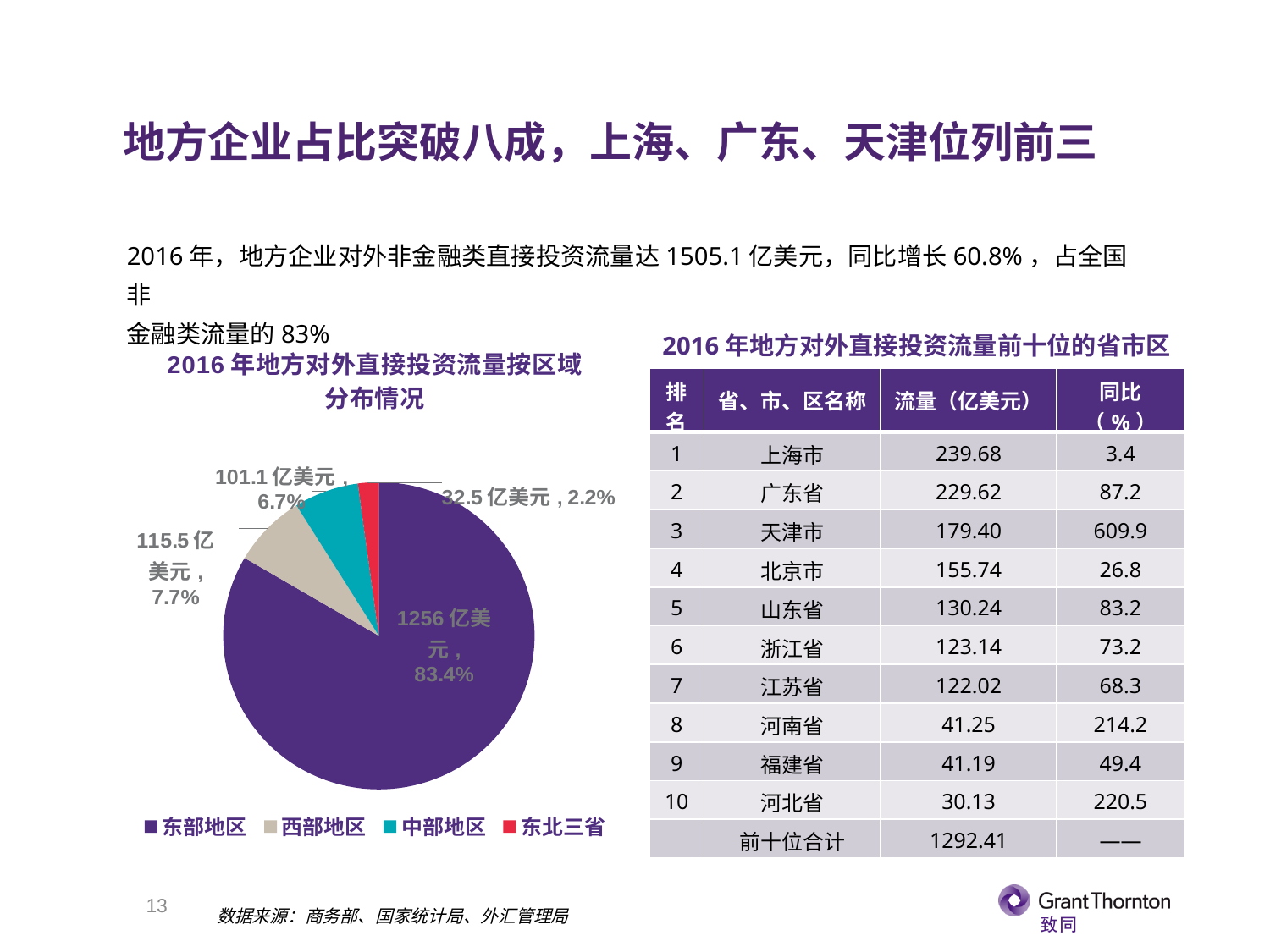
Which region has the smallest slice in the pie chart? 东北三省 In the pie chart, what is the value for 东北三省? 32.5 亿美元 In the pie chart, which is larger, 西部地区 or 中部地区? 西部地区 In the pie chart, what is the difference in value between 西部地区 and 中部地区? 14.4 亿美元 In the pie chart, what share does 东部地区 hold? 83.4% In the pie chart, what is the value for 西部地区? 115.5 亿美元 In the pie chart, what share does 中部地区 hold? 6.7% What is the title of the pie chart? 2016 年地方对外直接投资流量按区域分布情况 What kind of chart is shown on the left of the slide? Pie chart In the pie chart, what is the value for 东部地区? 1256 亿美元 How many slices does the pie chart have? 4 Which region has the largest slice in the pie chart? 东部地区